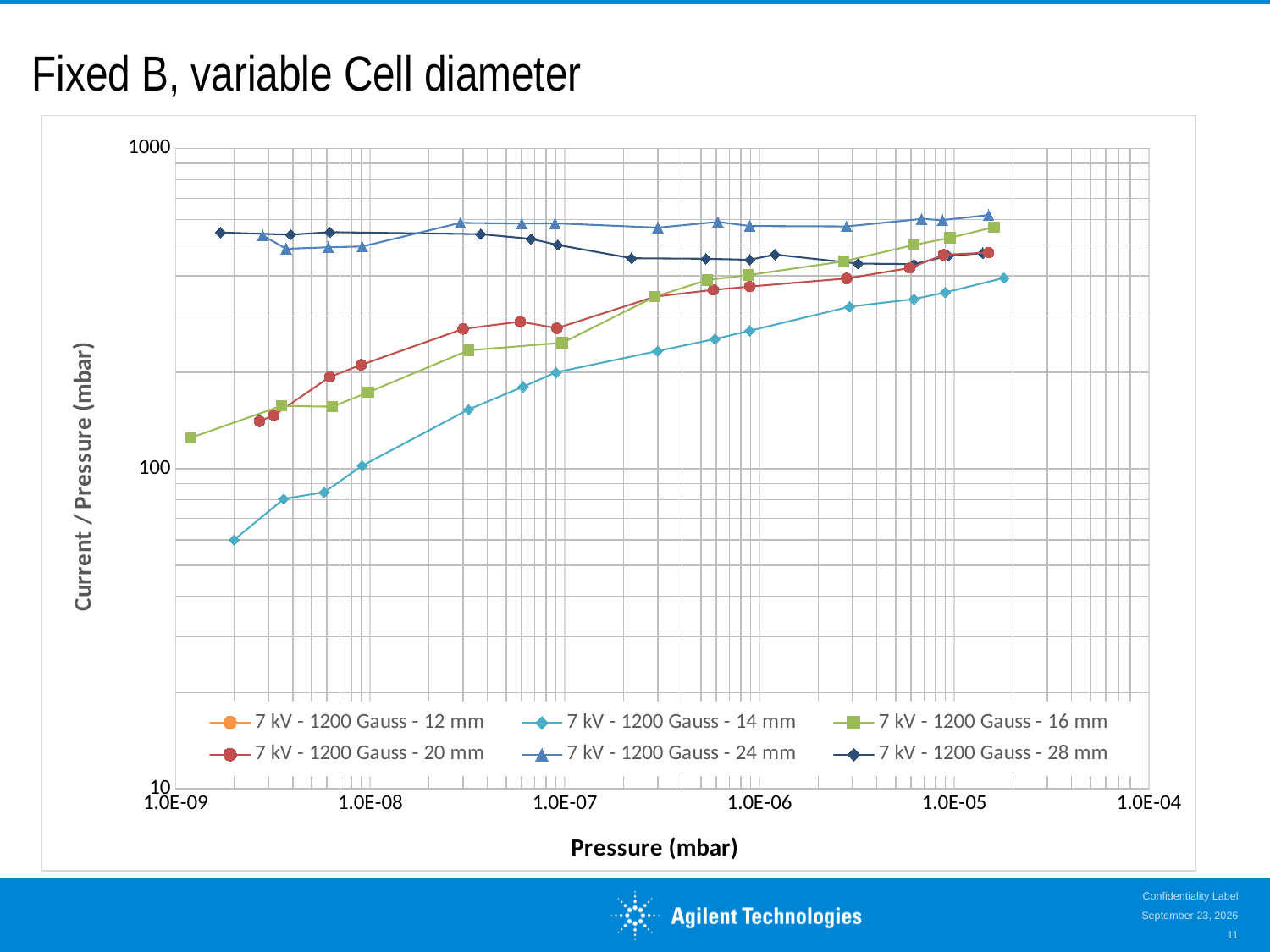
How many series does the chart legend list? 6 What kind of chart is shown on the slide? line chart Do the values of the 7 kV - 1200 Gauss - 14 mm series rise or fall as pressure increases? rise What is the label of the x axis? Pressure (mbar) Near a pressure of 1.0E-08 mbar, which series has the larger value: 7 kV - 1200 Gauss - 28 mm or 7 kV - 1200 Gauss - 14 mm? 7 kV - 1200 Gauss - 28 mm Is the value of the 7 kV - 1200 Gauss - 24 mm series at its highest pressure point greater or less than 1000? less What is the highest tick value shown on the y axis? 1000 Which series has the lowest values at the low-pressure (left) end of the chart? 7 kV - 1200 Gauss - 14 mm What is the label of the y axis? Current / Pressure (mbar) Is the value of the 7 kV - 1200 Gauss - 16 mm series at its lowest pressure point greater or less than 100? greater Is the value of the 7 kV - 1200 Gauss - 14 mm series at its lowest pressure point greater or less than 100? less Do the values of the 7 kV - 1200 Gauss - 16 mm series rise or fall as pressure increases? rise